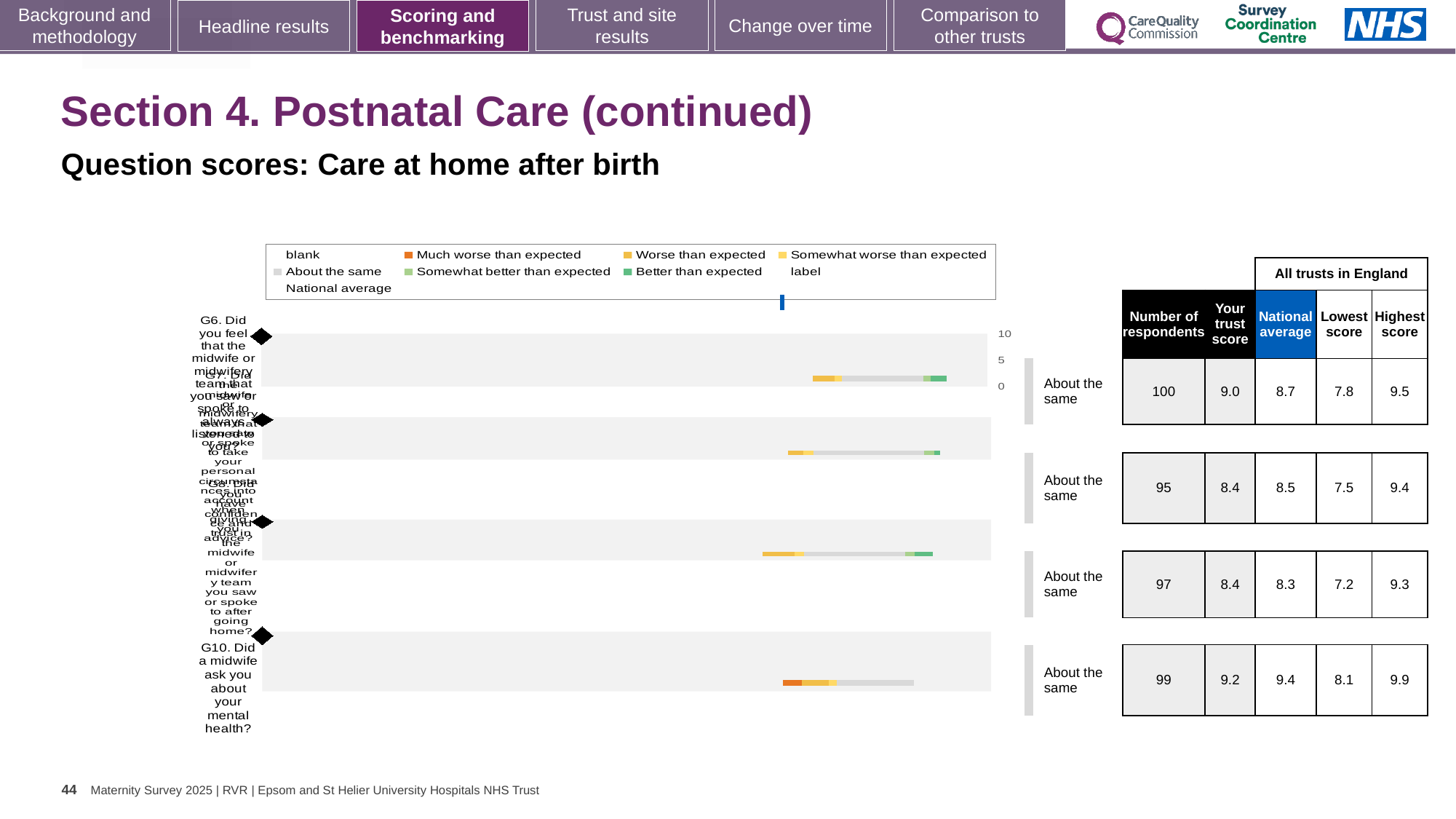
In the table beside the chart, what is the number of respondents for the top row (G6)? 100 Which question label appears on the bottom bar of the chart? G10. Did a midwife ask you about your mental health? In the table beside the chart, is the trust score for the top row (9.0) larger or smaller than the national average (8.7)? larger In the table beside the chart, which row has the highest 'Highest score' value? G10 (9.9) What kind of chart is shown on the slide? bar chart In the table beside the chart, what is the 'Your trust score' for the bottom row (G10)? 9.2 What rating text is shown beside the G10 bar? About the same What colour does the legend use for 'Better than expected'? green What is the highest tick value shown on the chart's axis? 10 How many question bars are plotted in the chart? 4